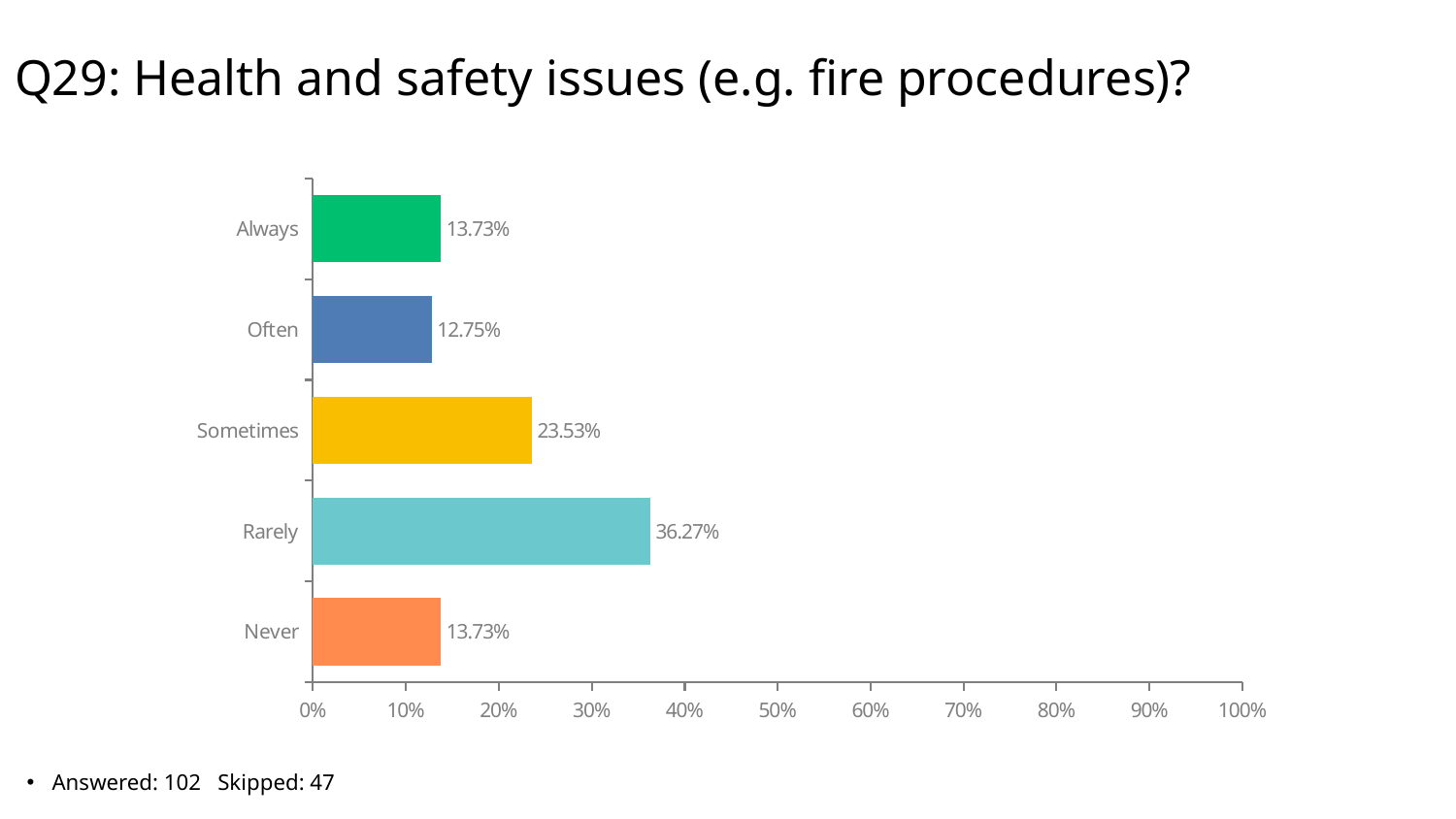
What is the title of the chart? Q29: Health and safety issues (e.g. fire procedures)? How many categories are shown in the chart? 5 What is the value for Always? 13.73% What kind of chart is shown on the slide? bar chart What is the value for Sometimes? 23.53% What is the value for Often? 12.75% Is the value for Rarely greater or less than 30%? greater Which is larger, the value for Sometimes or the value for Never? Sometimes What is the value for Rarely? 36.27% What is the difference between the values for Rarely and Sometimes? 12.74% Which category has the lowest value? Often Which category has the highest value? Rarely